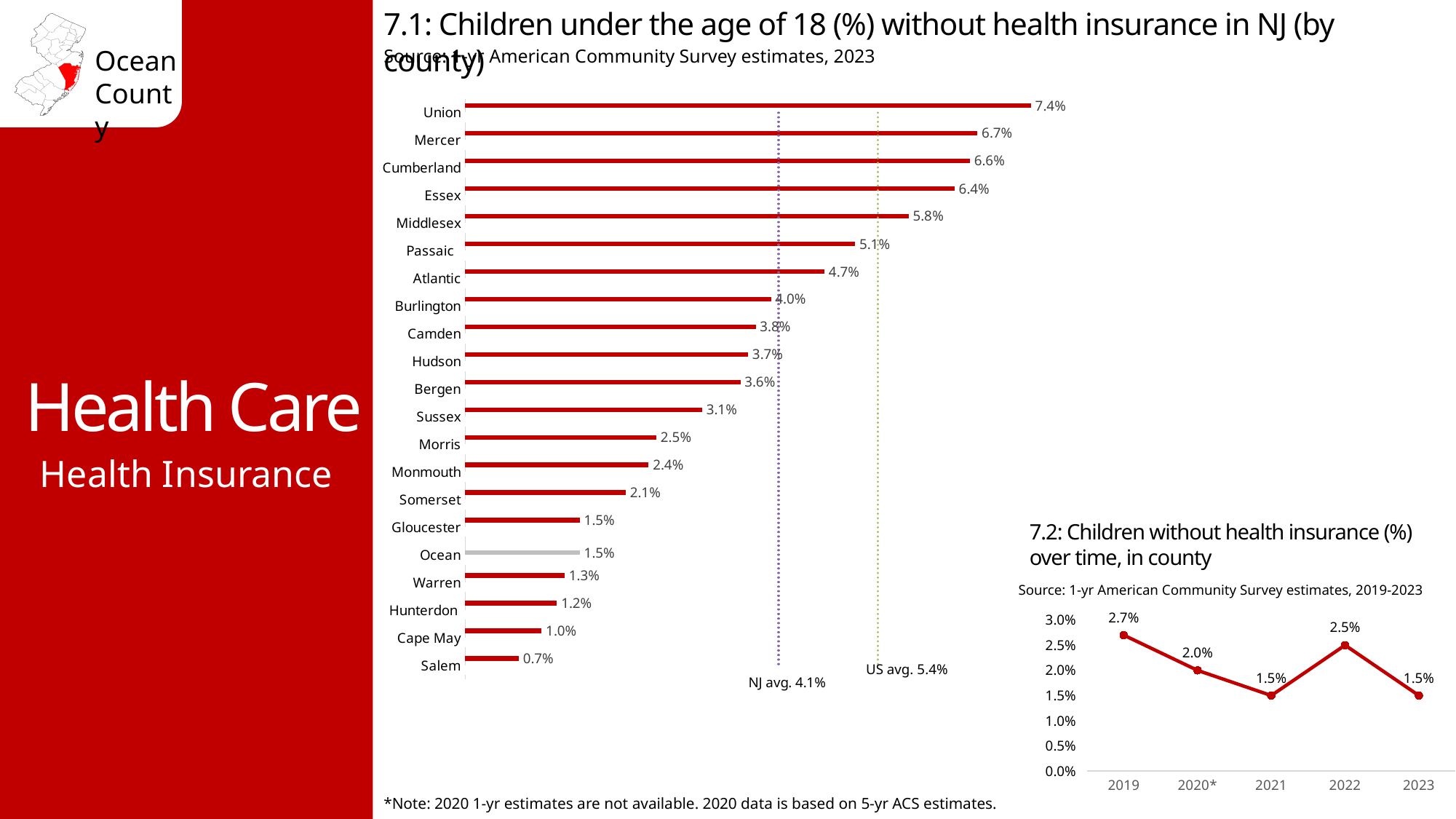
In chart 7.1, how many counties are shown? 21 What kind of chart is chart 7.2? line chart In chart 7.1, what is the value for Ocean? 1.5% In chart 7.1, what is the value for Union? 7.4% In chart 7.1, what is the NJ average shown by the dotted line? 4.1% In chart 7.1, which county has the highest value? Union In chart 7.1, which is larger, the value for Passaic or the value for Atlantic? Passaic In chart 7.2, how many years are plotted? 5 In chart 7.1, which county has the lowest value? Salem In chart 7.2, what is the value for 2022? 2.5% In chart 7.2, what is the difference between 2019 and 2023? 1.2% In chart 7.1, what is the difference between Mercer and Essex? 0.3%